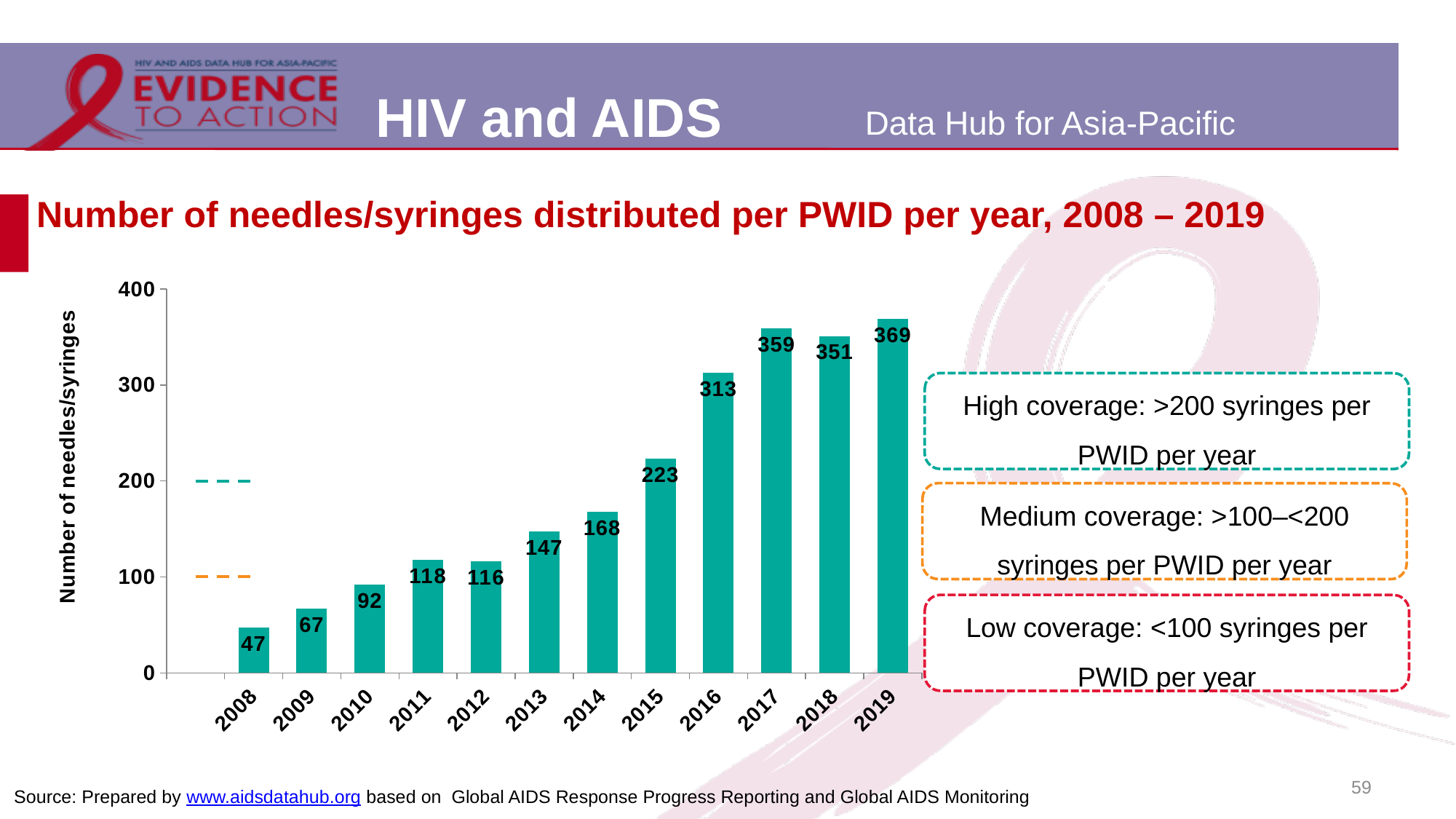
What is the difference between the values for 2017 and 2018? 8 What is the difference between the values for 2019 and 2008? 322 Which year has the lowest number of needles/syringes distributed per PWID? 2008 What is the number of needles/syringes distributed per PWID in 2019? 369 Which year has the highest number of needles/syringes distributed per PWID? 2019 What is the number of needles/syringes distributed per PWID in 2008? 47 Which year has a higher value, 2011 or 2012? 2011 What type of chart is shown on the slide? Bar chart Is the value for 2016 greater or less than 300? greater What is the number of needles/syringes distributed per PWID in 2015? 223 How many years are shown on the x axis of the chart? 12 What is the label of the y axis of the chart? Number of needles/syringes